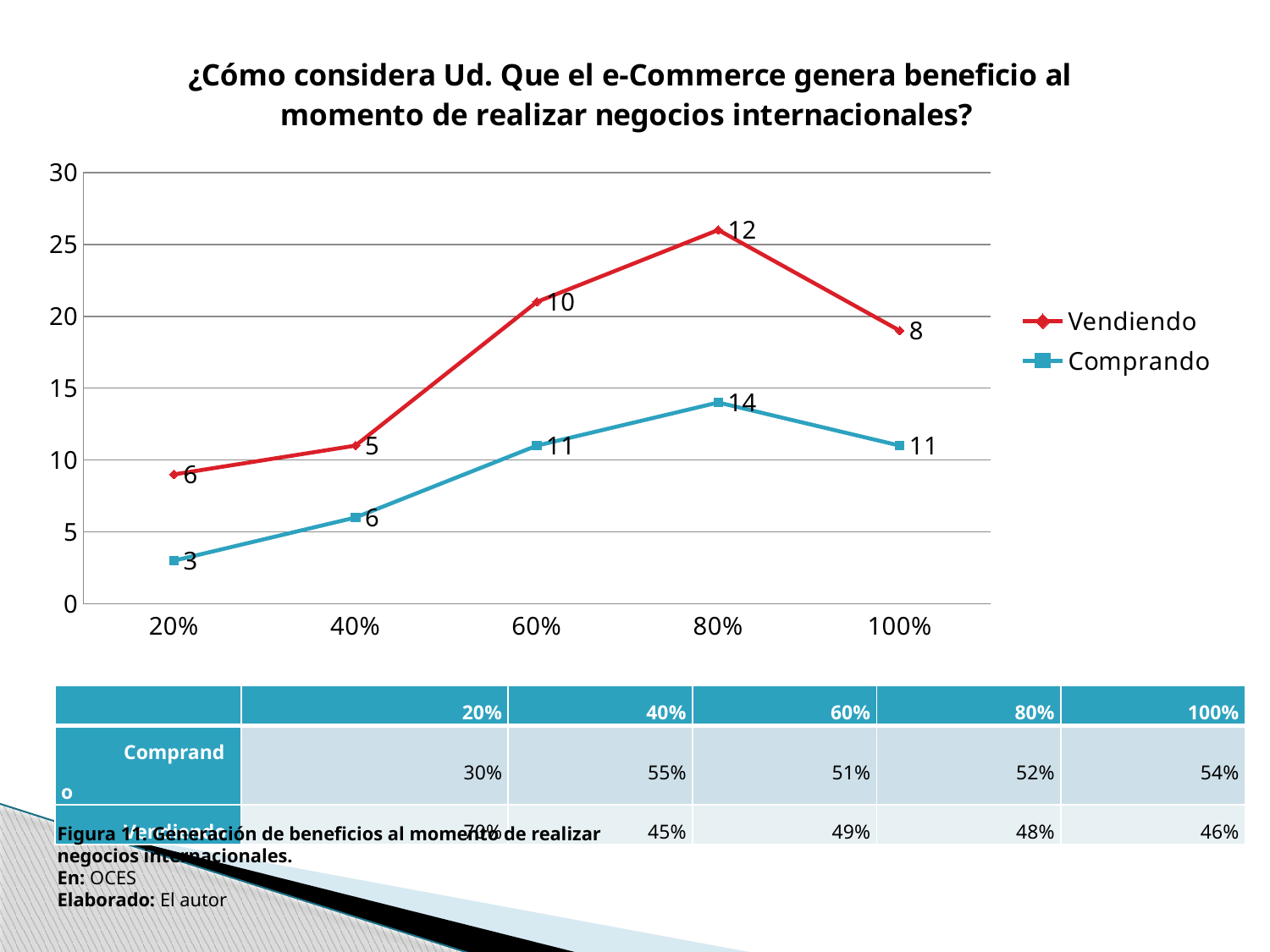
How many points are plotted along the x axis for each series? 5 What is the value for Comprando at 20%? 3 How many series does the chart legend list? 2 At which x-axis category does Comprando reach its highest value? 80% What is the value for Comprando at 40%? 6 What is the value for Comprando at 80%? 14 At which x-axis category does Comprando have its lowest value? 20% What is the difference between the highest and lowest values of Comprando? 11 Which series is drawn in red? Vendiendo What kind of chart is shown on the slide? line chart Does the Comprando line rise or fall from 20% to 80%? rise What is the value for Comprando at 100%? 11